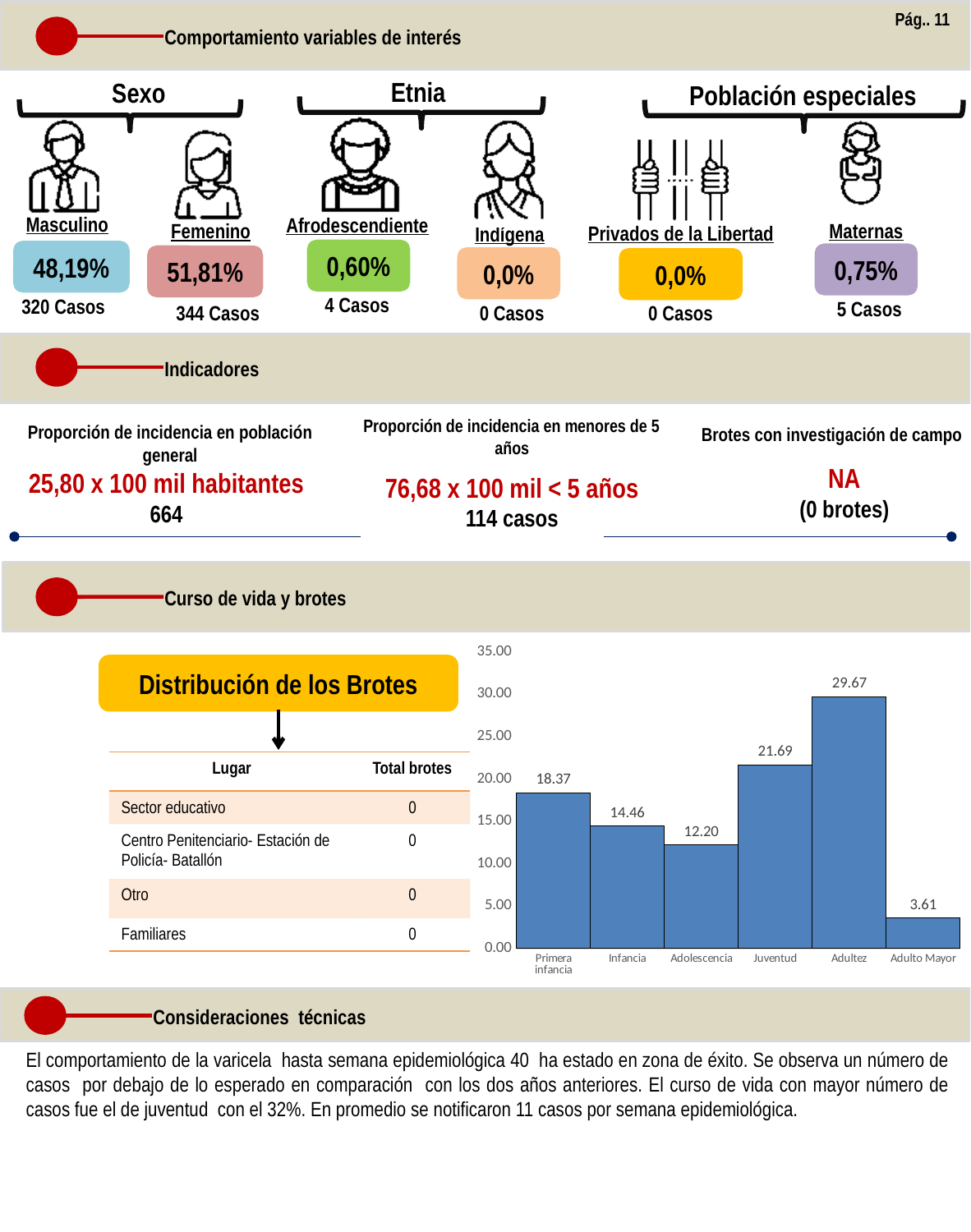
How many categories are shown on the x axis of the bar chart? 6 What is the value for Adolescencia in the bar chart? 12.20 What is the difference between the values for Adultez and Juventud in the bar chart? 7.98 What is the highest value shown on the y axis of the bar chart? 35.00 What kind of chart is shown in the 'Curso de vida y brotes' section? bar chart What is the value for Primera infancia in the bar chart? 18.37 What is the difference between the values for Infancia and Adolescencia in the bar chart? 2.26 Which category has the highest value in the bar chart? Adultez What is the value for Adultez in the bar chart? 29.67 Which category has the lowest value in the bar chart? Adulto Mayor Is the value for Juventud in the bar chart greater or less than 20.00? greater Which is larger in the bar chart, the value for Primera infancia or the value for Infancia? Primera infancia